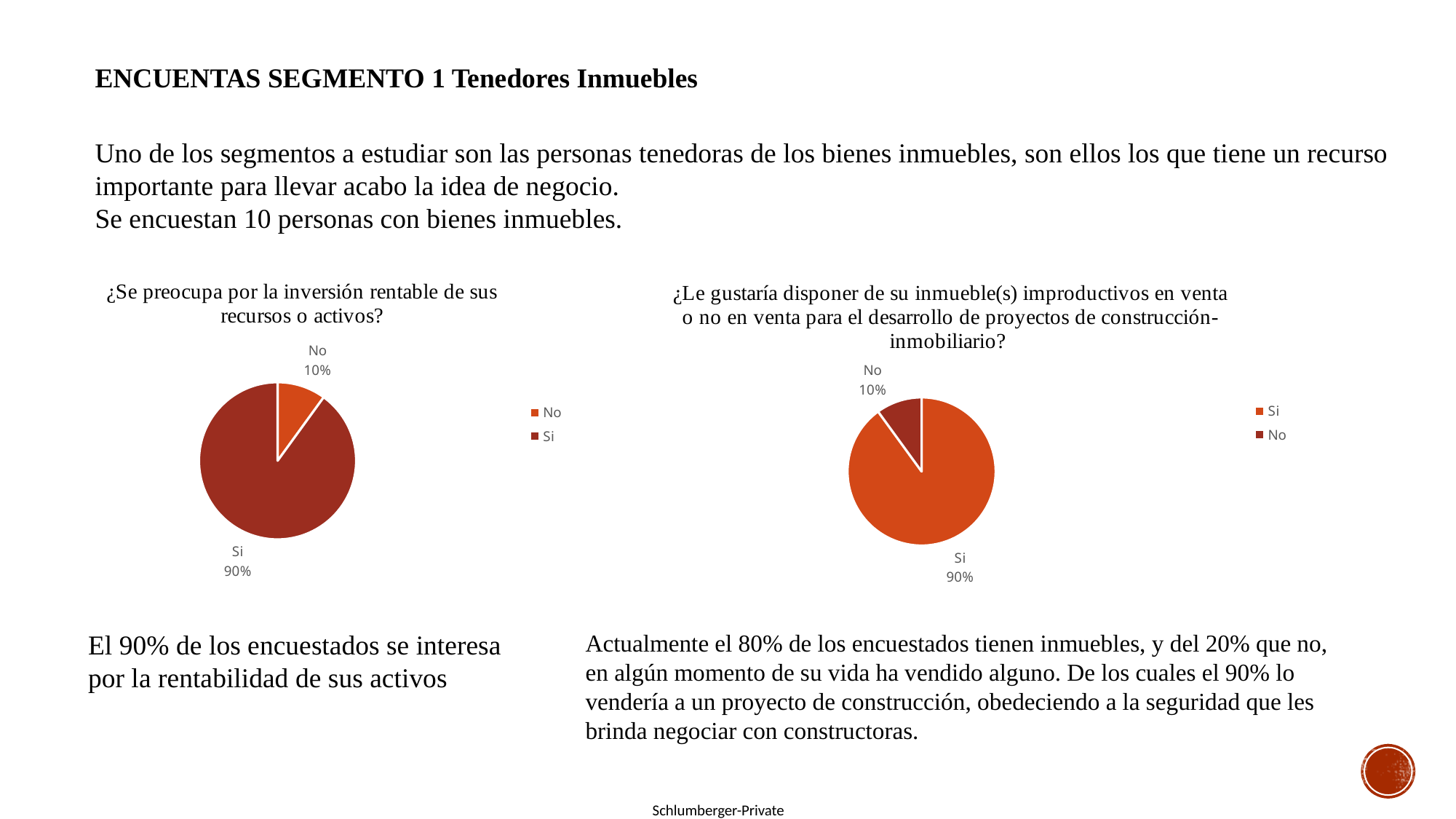
In the left pie chart (¿Se preocupa por la inversión rentable de sus recursos o activos?), what share of respondents answered Si? 90% In the left pie chart (¿Se preocupa por la inversión rentable de sus recursos o activos?), what share of respondents answered No? 10% In the right pie chart (¿Le gustaría disponer de su inmueble(s) improductivos...?), what share of respondents answered No? 10% In the left pie chart, which category has the largest slice? Si In the right pie chart, which slice is larger, Si or No? Si How many entries does the legend of the left pie chart list? 2 How many categories does the right pie chart show? 2 What type of chart is used on the left side of the slide? Pie chart In the left pie chart, what is the difference in percentage points between the Si and No slices? 80 percentage points What is the title of the left pie chart? ¿Se preocupa por la inversión rentable de sus recursos o activos? In the right pie chart, which category has the smallest slice? No